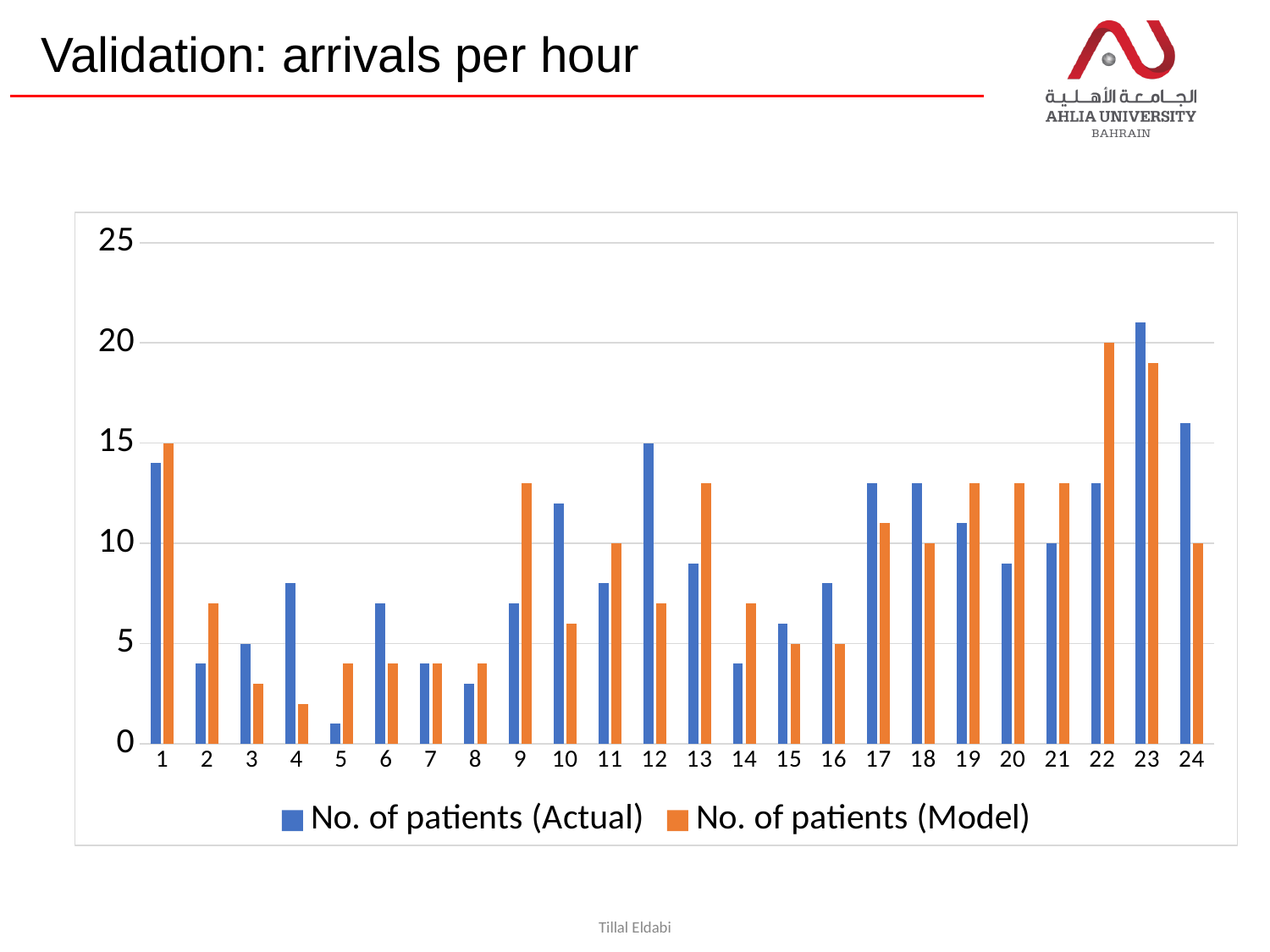
Is the value for No. of patients (Model) at hour 4 greater or less than 5? less What kind of chart is shown on the slide? bar chart What is the title of the slide containing the chart? Validation: arrivals per hour Is the value for No. of patients (Actual) at hour 5 greater or less than 5? less How many hours (categories) are shown on the x axis? 24 At hour 9, which is larger: No. of patients (Actual) or No. of patients (Model)? No. of patients (Model) Which hour has the lowest value for No. of patients (Actual)? 5 Which hour has the highest value for No. of patients (Model)? 22 Is the value for No. of patients (Actual) at hour 23 greater or less than 20? greater How many series does the legend list? 2 At hour 12, which is larger: No. of patients (Actual) or No. of patients (Model)? No. of patients (Actual) Which hour has the highest value for No. of patients (Actual)? 23